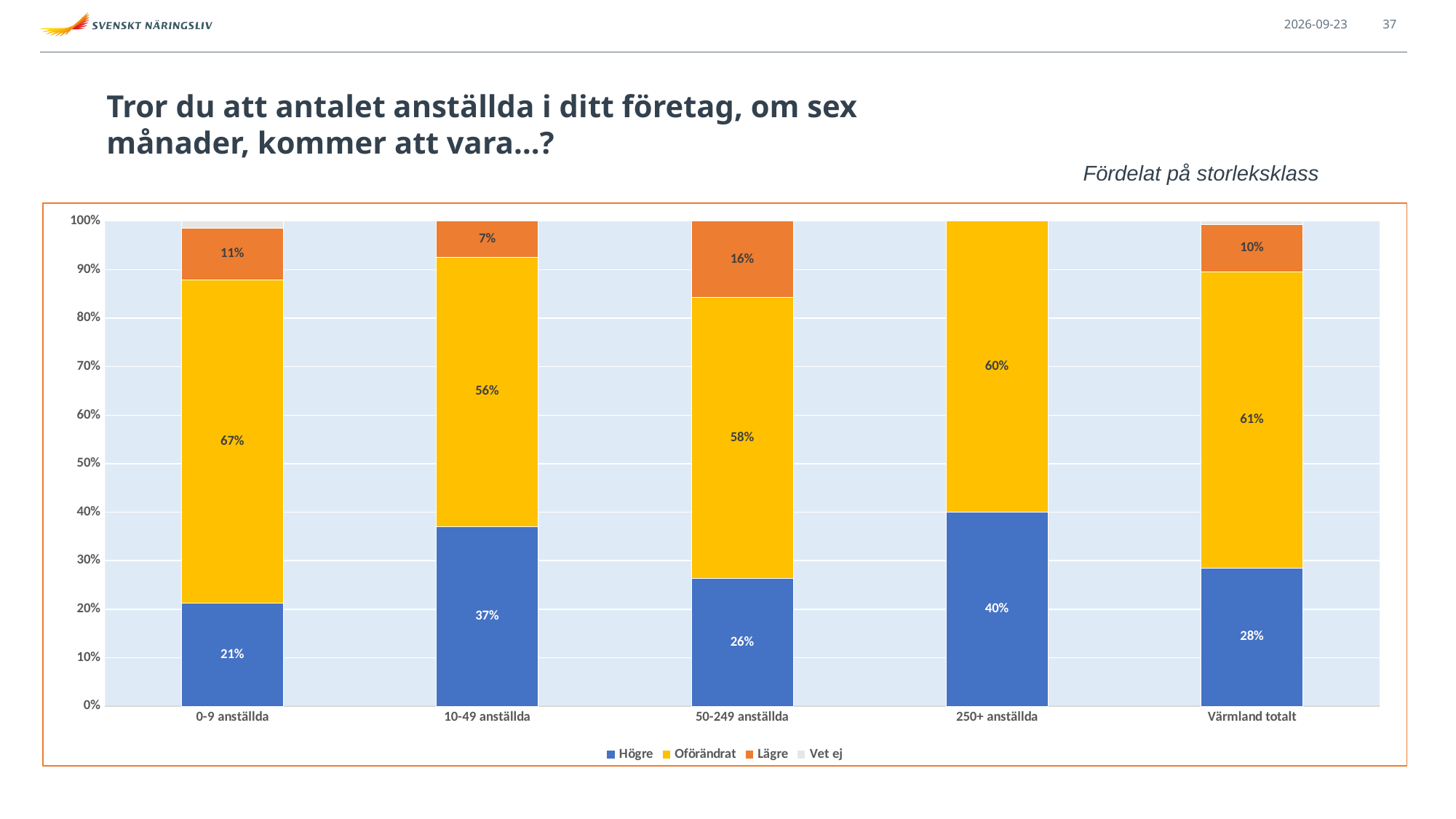
Which category has the lowest value for Lägre among those with a printed Lägre label? 10-49 anställda How many series does the legend list? 4 What is the difference between the Högre values for 10-49 anställda and 0-9 anställda? 16% What is the value for Högre in the 0-9 anställda category? 21% Which category has the highest value for Högre? 250+ anställda Which is larger: the Oförändrat value for 0-9 anställda or for 10-49 anställda? 0-9 anställda What is the value for Oförändrat in the 250+ anställda category? 60% What kind of chart is shown on the slide? Stacked bar chart How many categories are shown on the x axis? 5 What is the value for Lägre in the 50-249 anställda category? 16% Is the Högre value for 250+ anställda greater or less than 30%? greater What is the value for Högre for Värmland totalt? 28%